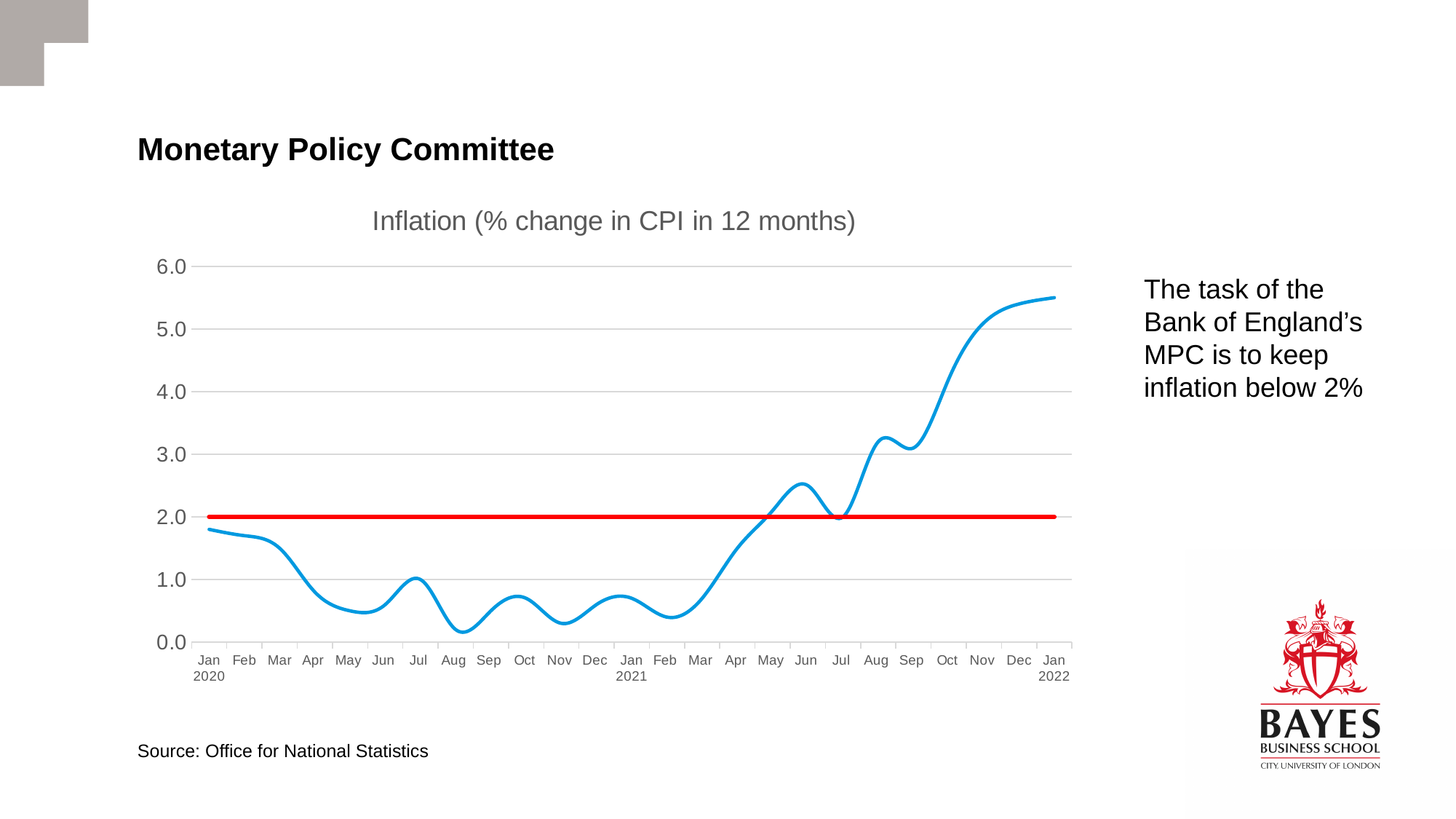
Is the inflation value for Jan 2022 greater or less than 5.0? greater How many monthly points are plotted on the x axis, from Jan 2020 to Jan 2022? 25 What kind of chart is shown on the slide? Line chart Which month has the highest inflation value on the chart? Jan 2022 Does inflation rise or fall between Jul 2021 and Jan 2022? Rises Which is larger, the inflation value for Jun 2021 or for Jun 2020? Jun 2021 What source is cited for the chart data? Office for National Statistics Is the inflation value for Apr 2021 greater or less than 2.0? less Is the inflation value for Jan 2020 greater or less than 2.0? less What is the title of the chart? Inflation (% change in CPI in 12 months) At what value on the y axis is the horizontal red line drawn? 2.0